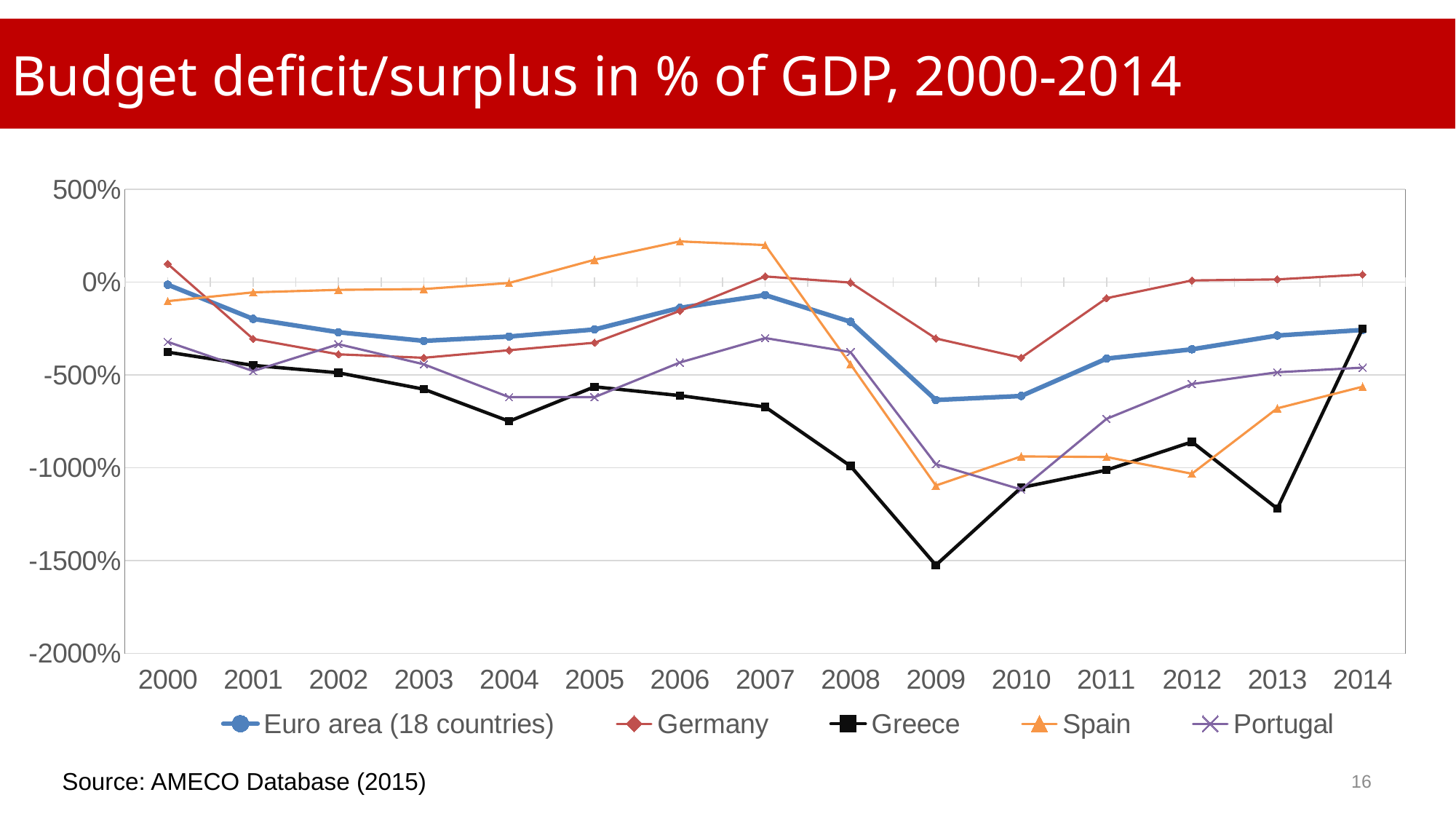
How many years are plotted along the x axis? 15 Is the value for Spain in 2006 greater or less than 0%? greater How many series does the legend list? 5 Is the value for Greece in 2009 greater or less than -1000%? less In which year does Greece reach its lowest value? 2009 What kind of chart is shown on the slide? line chart What is the title of the chart? Budget deficit/surplus in % of GDP, 2000-2014 Is the value for Germany in 2010 greater or less than -500%? greater Does the Greece line rise or fall from 2009 to 2014? rise Which series has the highest value in 2006? Spain In 2009, which is larger: the value for Spain or the value for Greece? Spain Which series reaches the lowest value anywhere on the chart? Greece